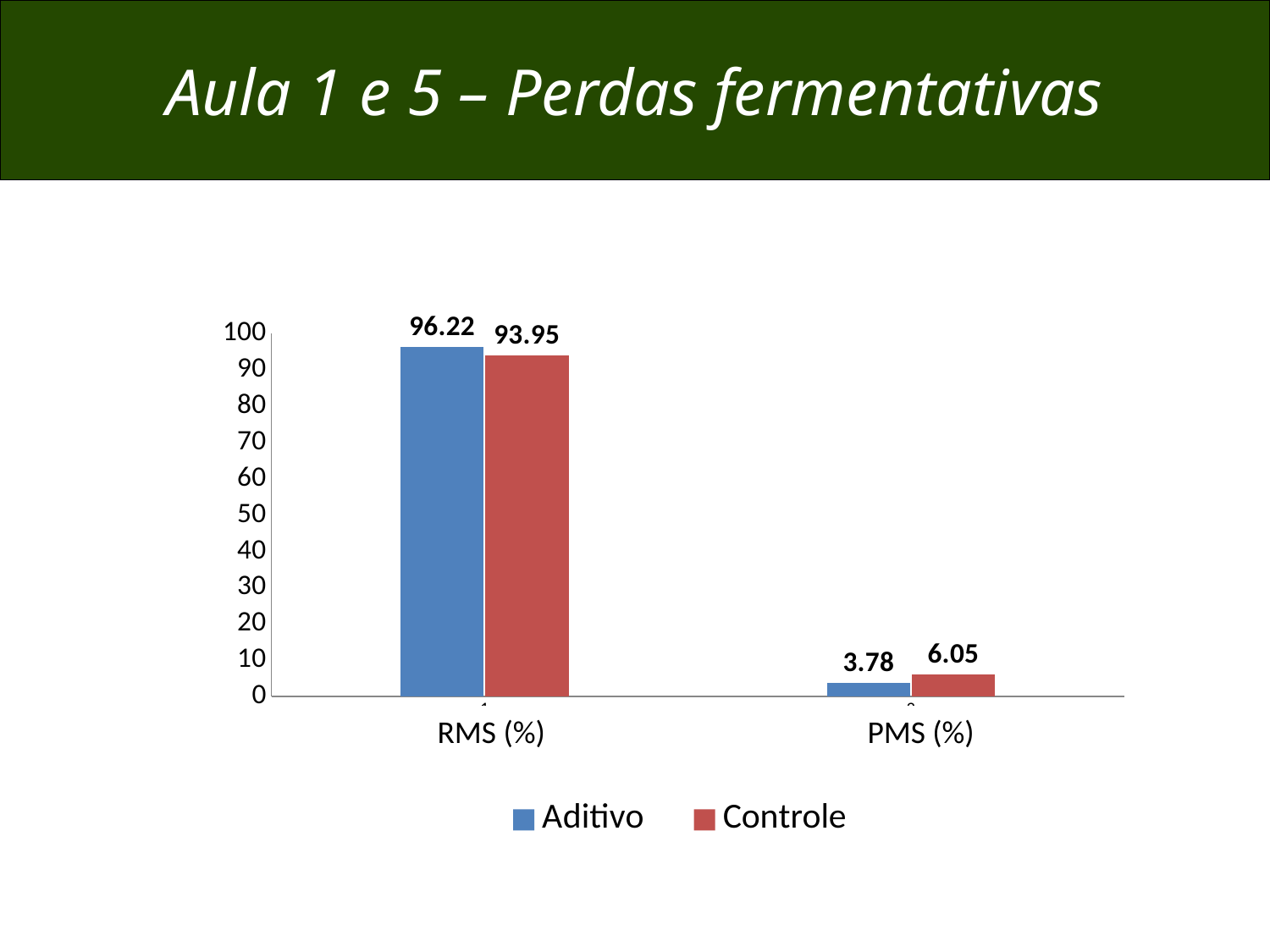
What is the difference between the Controle and Aditivo values for PMS (%)? 2.27 Which series has the higher value for RMS (%)? Aditivo What is the Aditivo value for RMS (%)? 96.22 How many categories are shown on the x axis? 2 Which series has the higher value for PMS (%)? Controle What is the difference between the Aditivo and Controle values for RMS (%)? 2.27 How many series does the legend list? 2 What is the Aditivo value for PMS (%)? 3.78 What is the Controle value for PMS (%)? 6.05 What colour represents the Controle series? Red What kind of chart is shown on the slide? Bar chart What is the Controle value for RMS (%)? 93.95